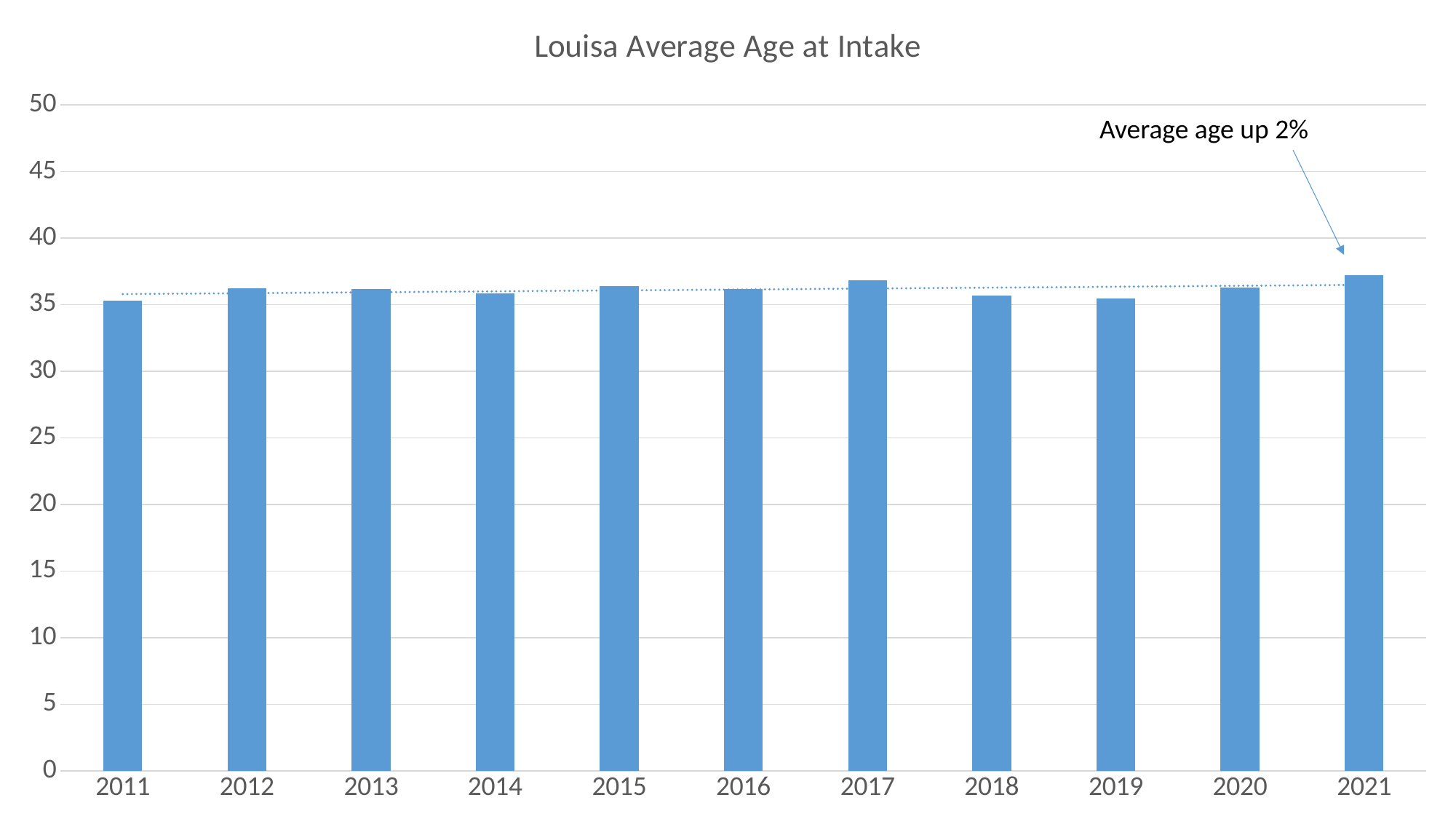
What kind of chart is shown on the slide? bar chart Is the value for 2021 greater or less than 35? greater Which is larger, the value for 2017 or the value for 2019? 2017 How many years are shown on the x axis of the chart? 11 Is the value for 2019 greater or less than 40? less What does the annotation with the arrow pointing to the 2021 bar say? Average age up 2% Which is larger, the value for 2021 or the value for 2011? 2021 Which year has the highest average age at intake? 2021 According to the dotted trend line, do the values generally rise or fall from 2011 to 2021? rise Is the value for 2015 greater or less than 30? greater What is the title of the chart? Louisa Average Age at Intake